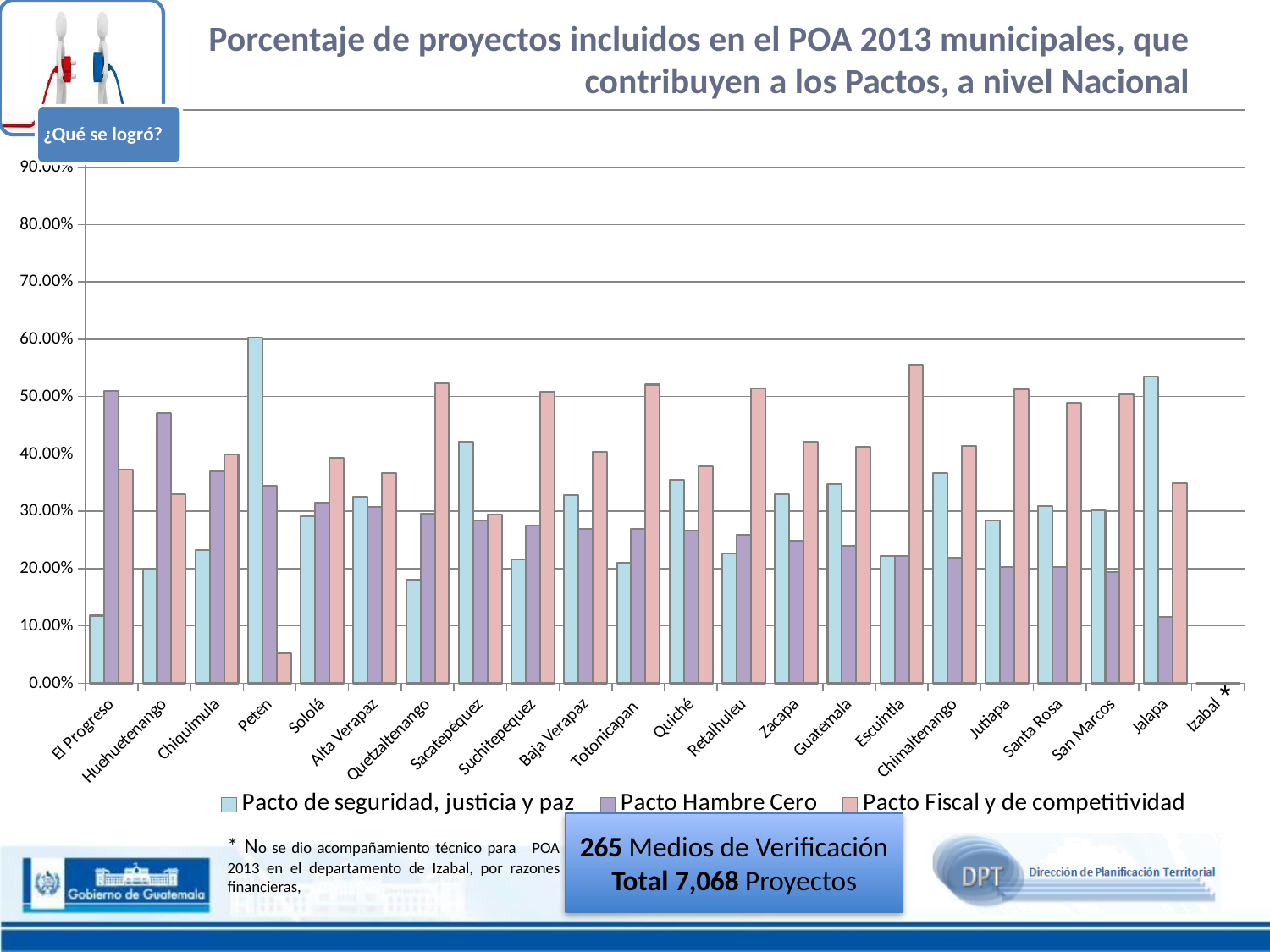
Which legend entry is shown in light blue? Pacto de seguridad, justicia y paz How many series does the legend list? 3 Which department has the highest value for Pacto Hambre Cero? El Progreso Excluding Izabal, which department has the lowest value for Pacto Fiscal y de competitividad? Peten Is the value for Pacto de seguridad, justicia y paz in Peten greater or less than 50.00%? greater Which department has the highest value for Pacto de seguridad, justicia y paz? Peten What kind of chart is shown on the slide? bar chart Is the value for Pacto Fiscal y de competitividad in Peten greater or less than 10.00%? less How many departments (categories) are shown on the x axis? 22 Which department has the highest value for Pacto Fiscal y de competitividad? Escuintla In El Progreso, which is larger: Pacto Hambre Cero or Pacto de seguridad, justicia y paz? Pacto Hambre Cero Is the value for Pacto de seguridad, justicia y paz in El Progreso greater or less than 20.00%? less